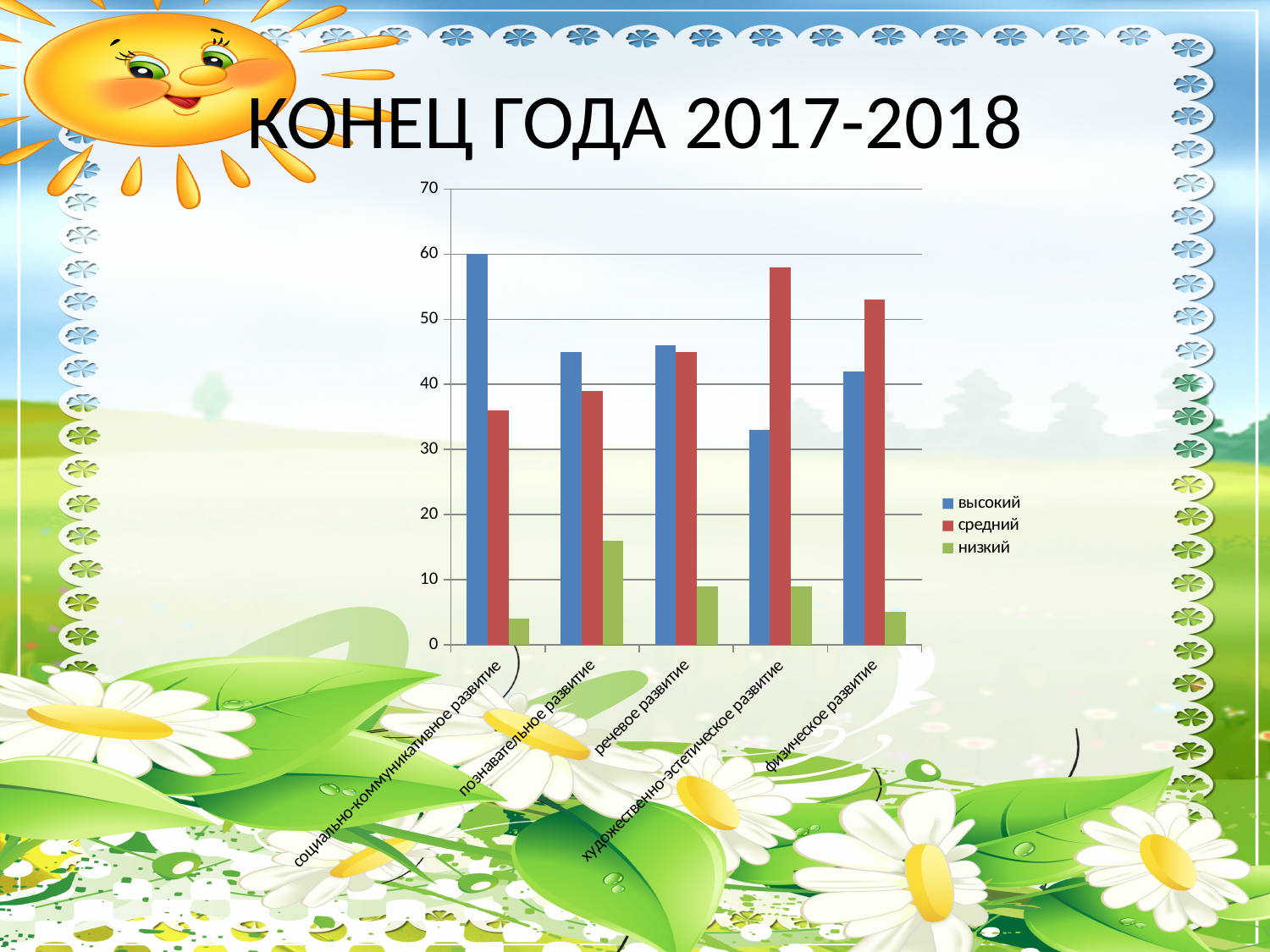
For художественно-эстетическое развитие, which is larger: высокий or средний? средний What is the value of высокий for социально-коммуникативное развитие? 60 Which category has the lowest высокий value? художественно-эстетическое развитие What kind of chart is shown on the slide? bar chart Which category has the highest высокий value? социально-коммуникативное развитие Is the value of низкий for познавательное развитие greater or less than 20? less Is the value of средний for физическое развитие greater or less than 50? greater How many categories are shown on the x axis? 5 Which category has the highest средний value? художественно-эстетическое развитие How many series does the legend list? 3 What is the title of the slide above the chart? КОНЕЦ ГОДА 2017-2018 Which category has the highest низкий value? познавательное развитие